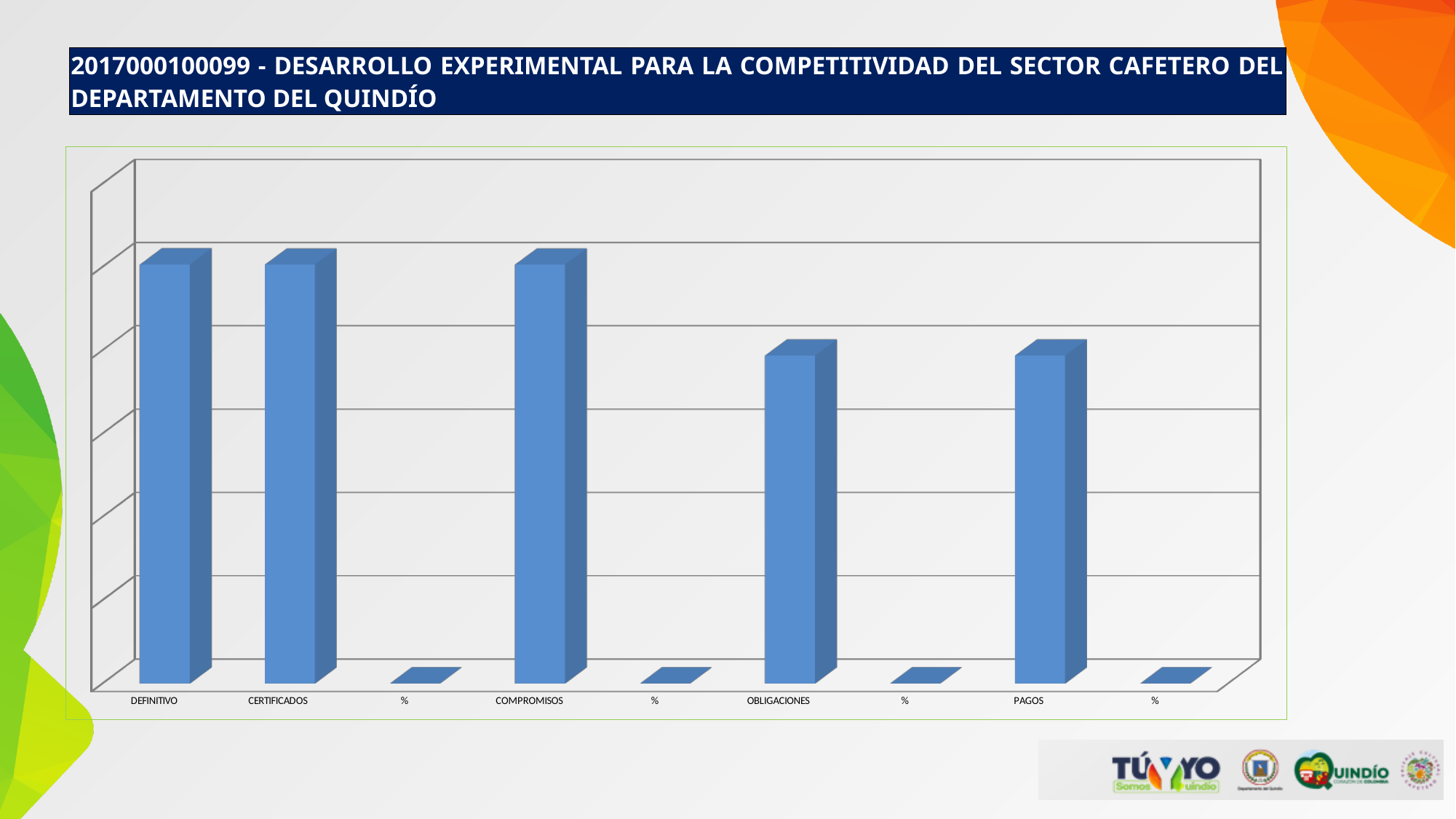
How many categories are shown along the x axis of the chart? 9 Which is larger, the value for COMPROMISOS or the value for PAGOS? COMPROMISOS Which is larger, the value for OBLIGACIONES or the value for the % category immediately to its right? OBLIGACIONES Which is larger, the value for CERTIFICADOS or the value for PAGOS? CERTIFICADOS What kind of chart is shown on the slide? Bar chart What colour are the bars in the chart? Blue What is the label of the first category on the x axis? DEFINITIVO